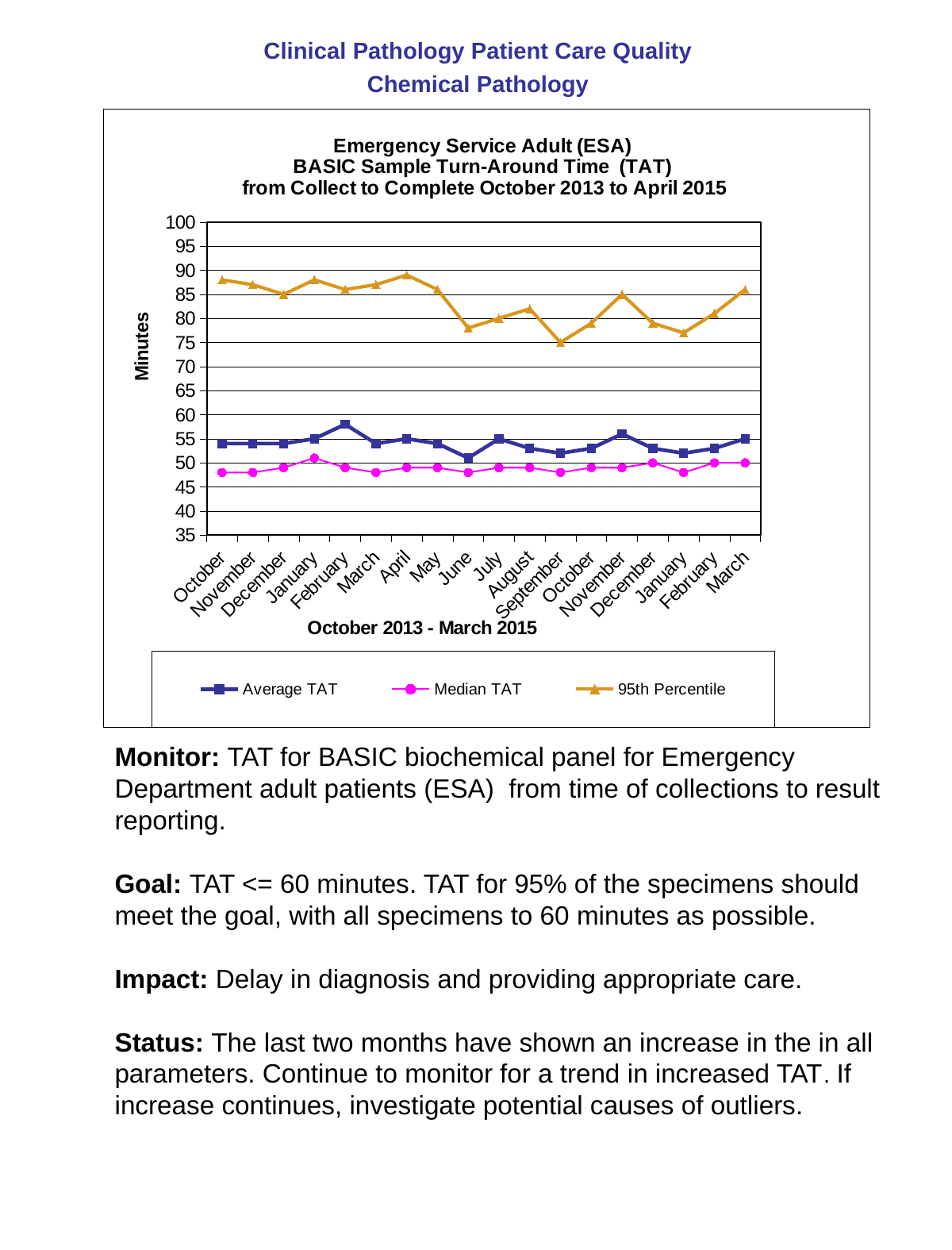
How many months are plotted along the x axis? 18 Is the Median TAT value for June greater or less than 50? less In which month is the Average TAT highest? February (2014) Is the Average TAT value for the first February greater or less than 55? greater What kind of chart is shown on the slide? Line chart Is the 95th Percentile value for September greater or less than 80? less Does the 95th Percentile rise or fall from April to June? Fall In which month is the 95th Percentile lowest? September How many series does the legend list? 3 What is the label on the y axis? Minutes Is the 95th Percentile higher in April or in September? April